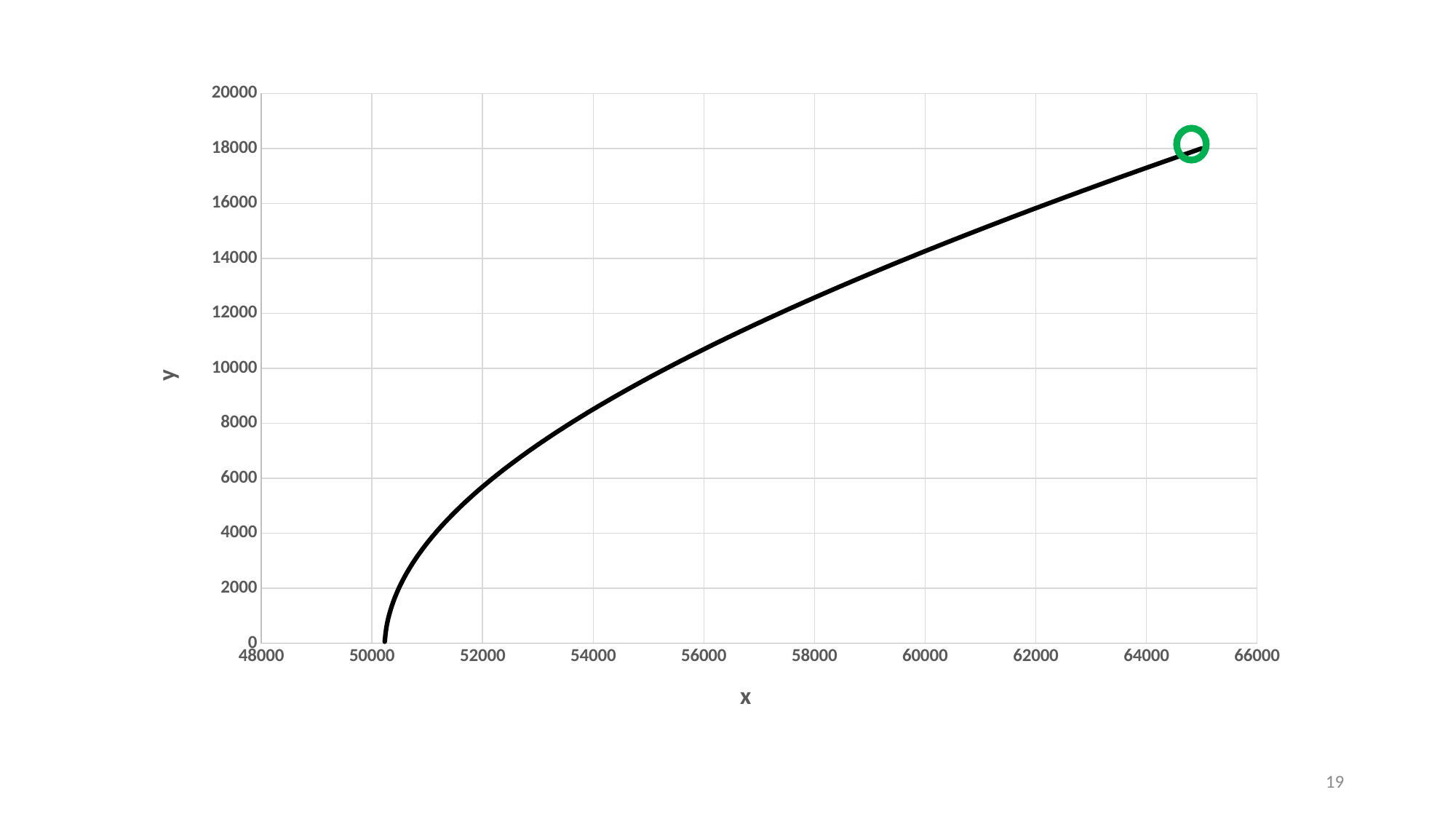
Is the value of y at x = 64000 greater or less than 18000? less What is the label of the horizontal axis? x Is the value of y at x = 56000 greater or less than 10000? greater Is the x value where the curve starts (at y = 0) greater or less than 50000? greater How many curves are plotted on the chart? 1 Does the plotted curve rise or fall as x increases? rise What kind of chart is shown on the slide? line chart What is the highest tick value shown on the vertical axis? 20000